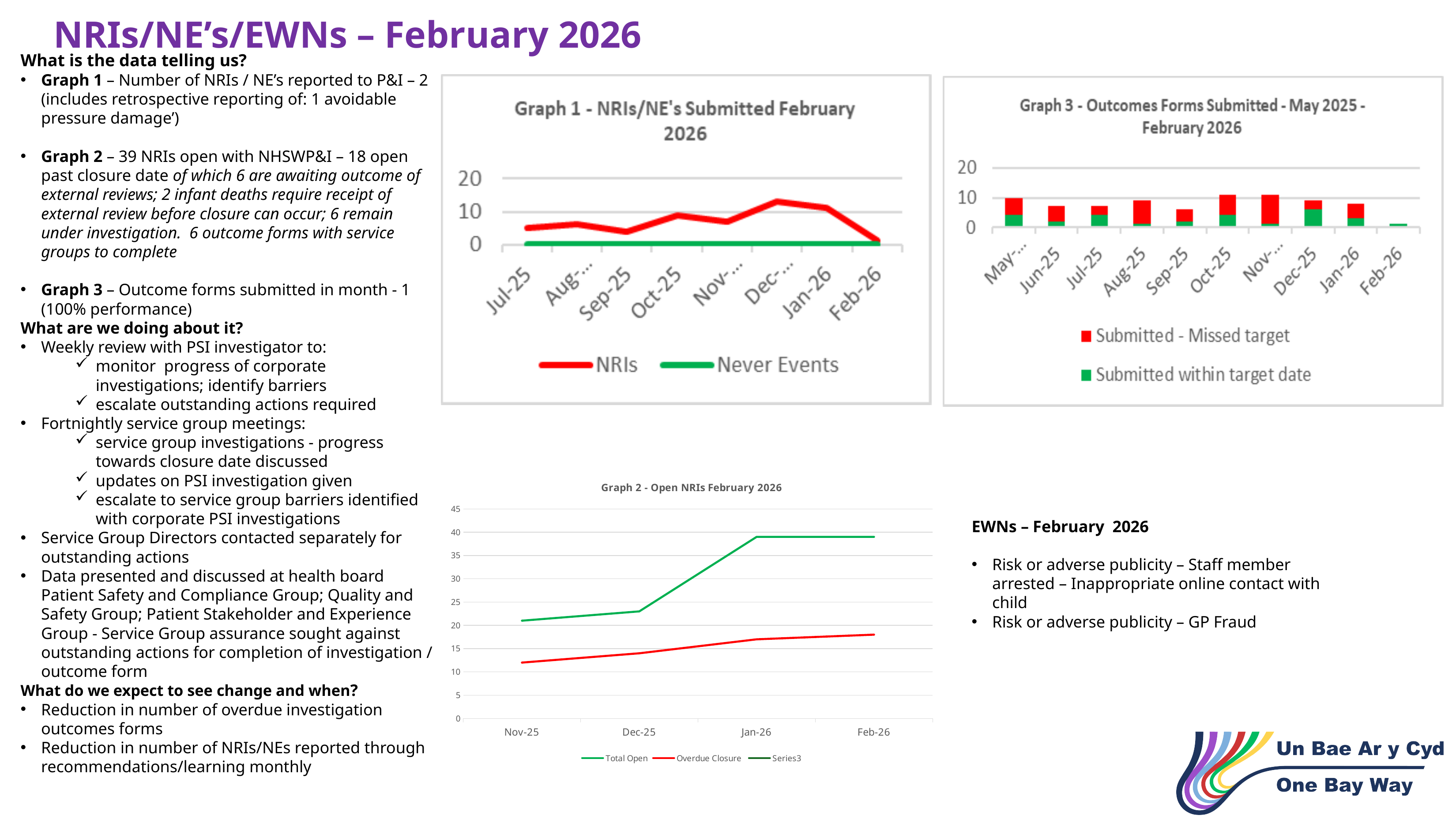
What kind of chart is Graph 1 - NRIs/NE's Submitted February 2026? Line chart In Graph 2, is the Total Open value for Jan-26 greater or less than 35? greater How many months are shown on the x axis of Graph 3? 10 In Graph 2, does the Total Open line rise or fall from Nov-25 to Feb-26? Rises How many series does the legend of Graph 2 - Open NRIs February 2026 list? 3 How many series does the legend of Graph 3 list? 2 In Graph 1, is the NRIs value for Feb-26 greater or less than 10? less What kind of chart is Graph 3 - Outcomes Forms Submitted? Bar chart How many series does the legend of Graph 1 list? 2 In Graph 1, is the NRIs value for Dec-25 greater or less than 10? greater In Graph 3, which month has the lowest total bar? Feb-26 In Graph 1, which month has the highest number of NRIs? Dec-25